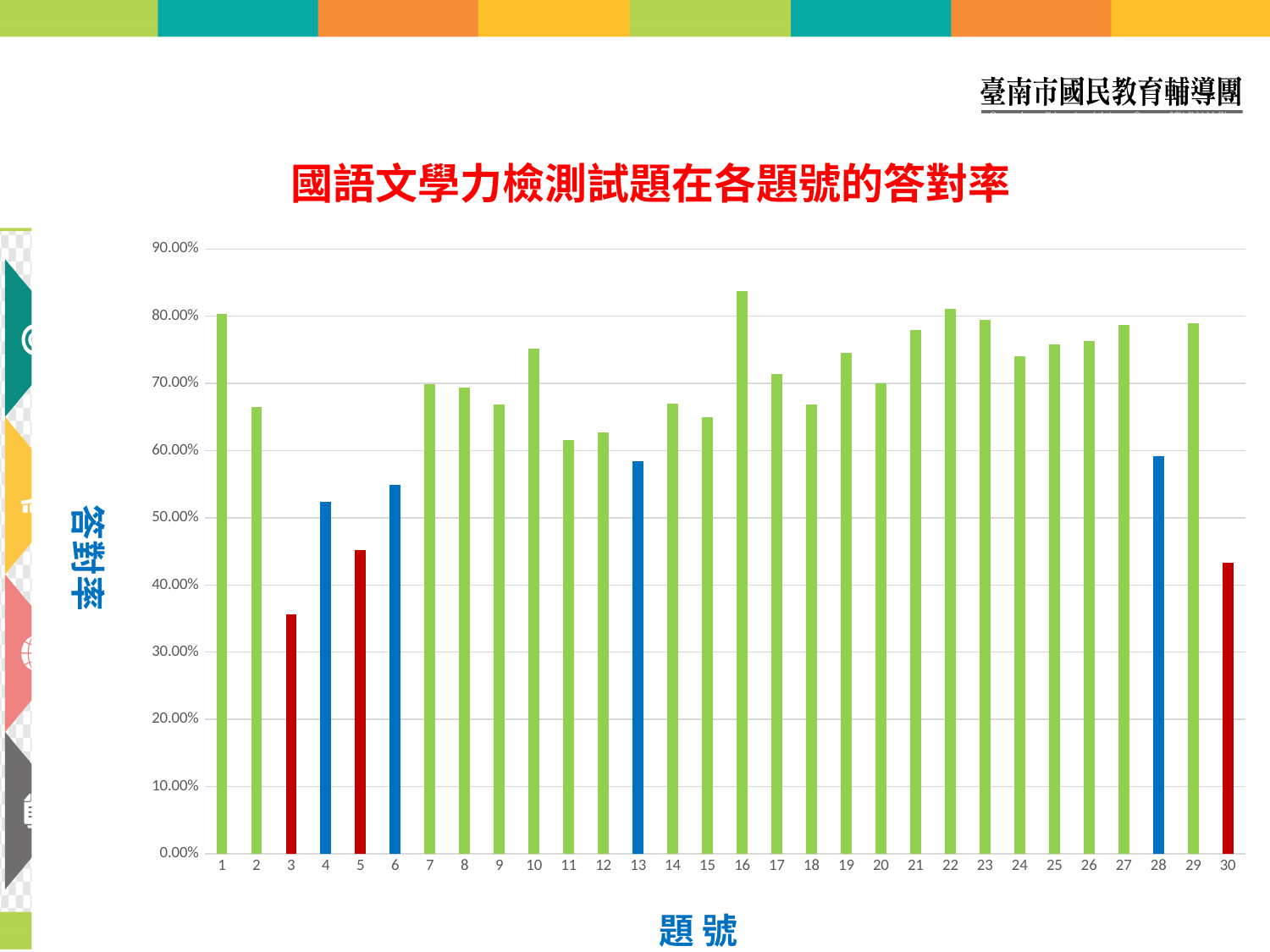
Is the 答對率 for question 13 greater or less than 60.00%? less Which has a higher 答對率, question 30 or question 3? question 30 How many bars in the chart are coloured red? 3 Which question number has the highest 答對率? 16 Is the 答對率 for question 16 greater or less than 80.00%? greater Which has a higher 答對率, question 1 or question 2? question 1 What is the title of the chart? 國語文學力檢測試題在各題號的答對率 Is the 答對率 for question 3 greater or less than 40.00%? less What kind of chart is shown on the slide? bar chart Which question number has the lowest 答對率? 3 How many question numbers (題號) are plotted along the x axis? 30